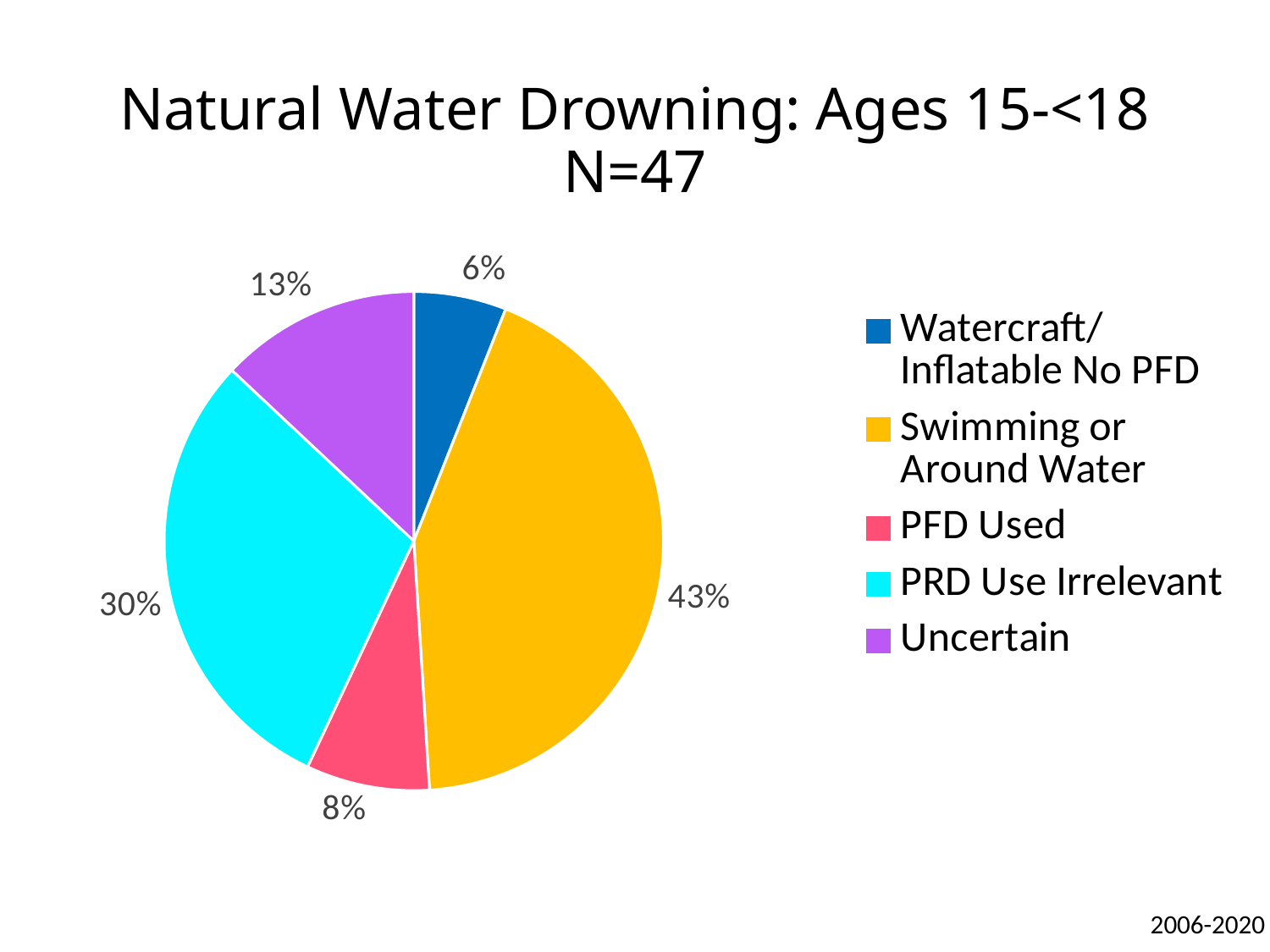
What is the N value stated in the chart title? 47 What kind of chart is shown on the slide? pie chart What share of the pie is Swimming or Around Water? 43% What share of the pie is PRD Use Irrelevant? 30% Which is larger, the Uncertain slice or the PFD Used slice? Uncertain Which category has the largest slice of the pie? Swimming or Around Water What share of the pie is Uncertain? 13% How many categories does the pie chart have? 5 Which category has the smallest slice of the pie? Watercraft/Inflatable No PFD What is the difference in percentage points between Swimming or Around Water and PRD Use Irrelevant? 13